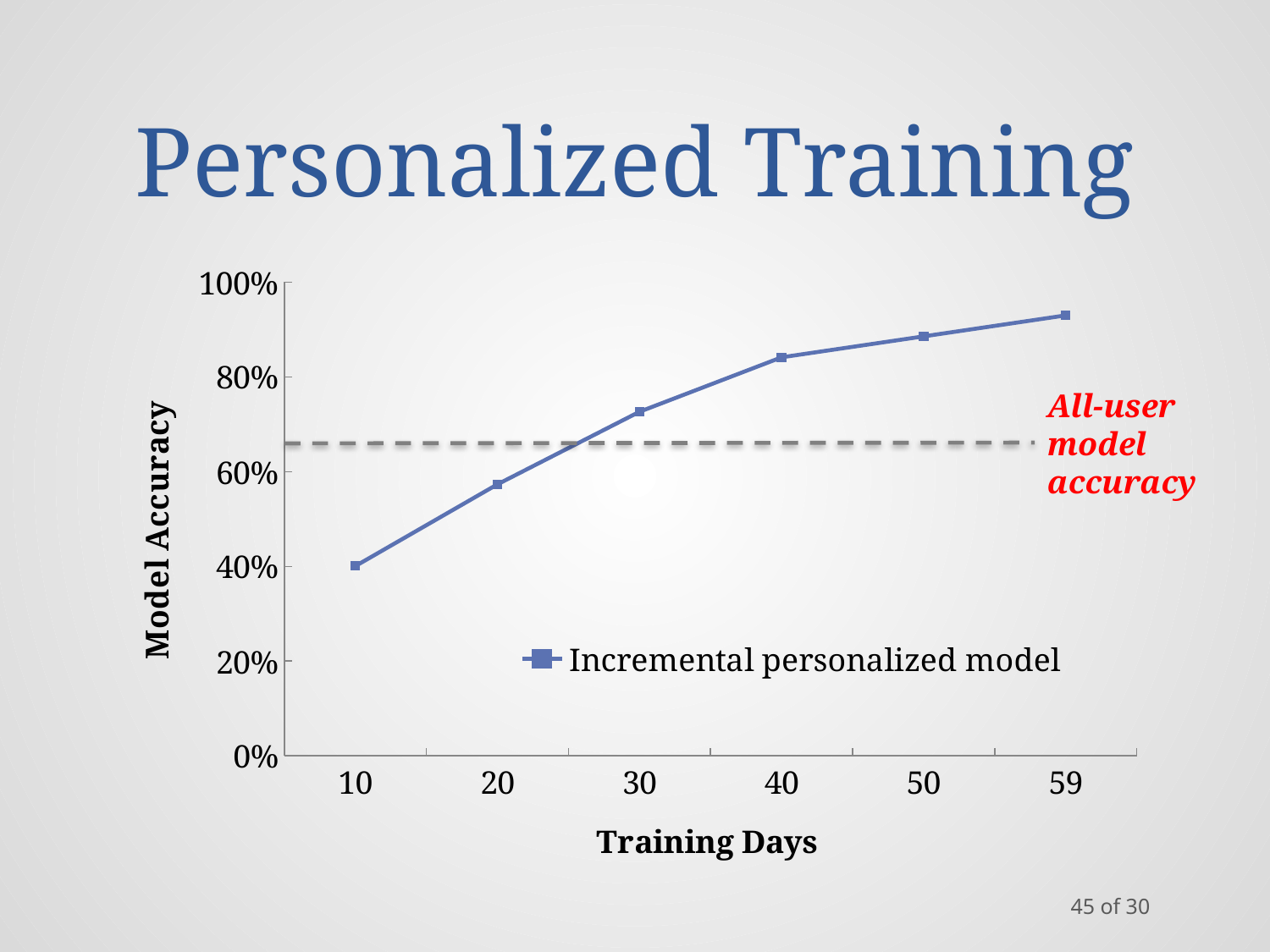
Does the model accuracy rise or fall as training days increase? rise Is the model accuracy at 59 training days greater or less than 100%? less How many series does the legend list? 1 At which number of training days is the model accuracy lowest? 10 What kind of chart is shown on the slide? line chart Is the model accuracy at 10 training days greater or less than 60%? less How many data points are plotted for the Incremental personalized model series? 6 Is the model accuracy at 40 training days greater or less than 80%? greater Which has higher model accuracy: 20 training days or 50 training days? 50 training days At which number of training days is the model accuracy highest? 59 What is the title of the y axis? Model Accuracy